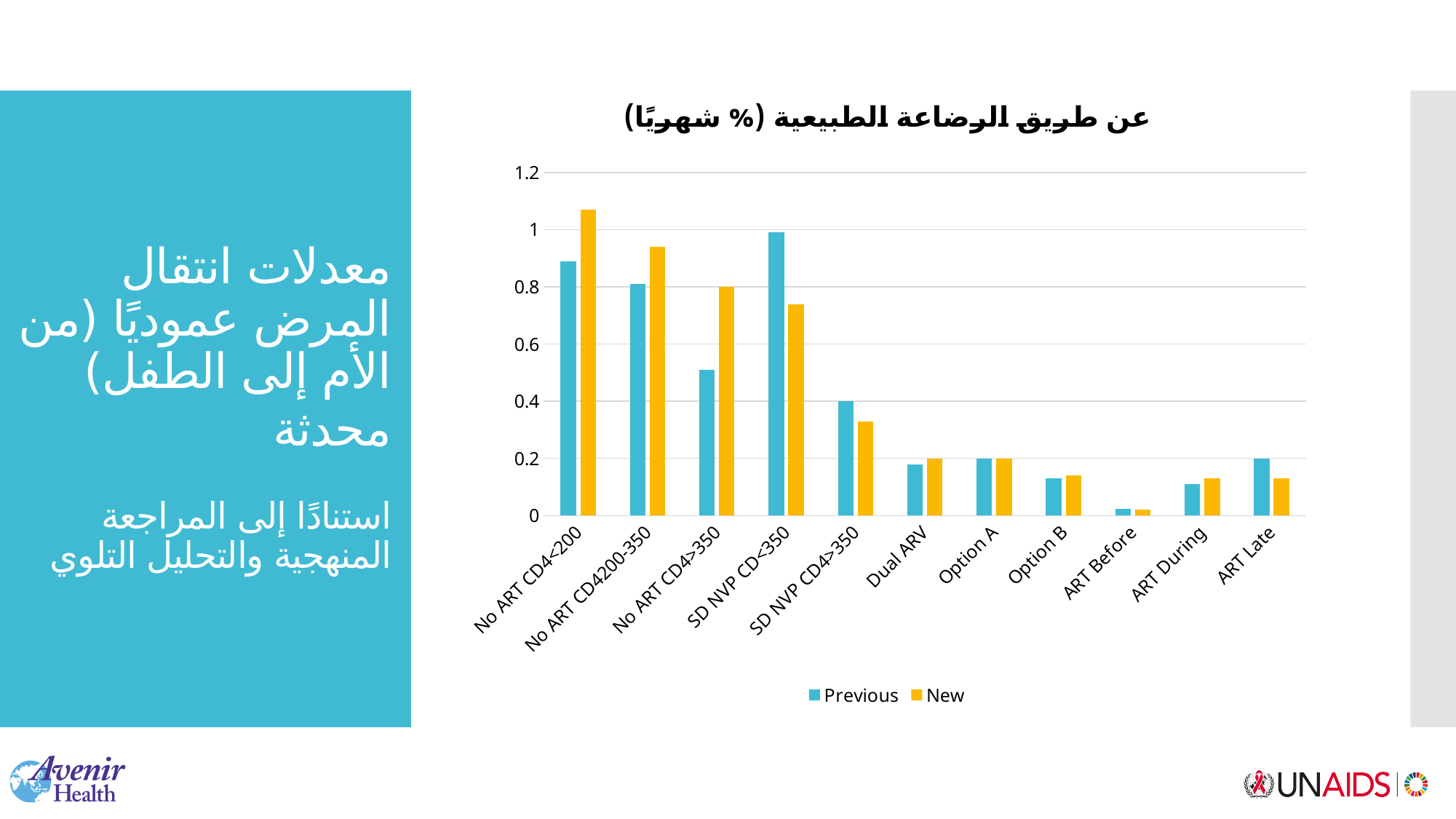
For No ART CD4<200, which is larger, the Previous value or the New value? New Is the New value for No ART CD4<200 greater or less than 1? greater What kind of chart is shown on the slide? bar chart Is the New value for SD NVP CD4>350 greater or less than 0.4? less For SD NVP CD<350, which is larger, the Previous value or the New value? Previous Which category has the tallest bar in the chart? No ART CD4<200 How many series does the chart's legend list? 2 Which series is shown in orange in the chart? New Which category has the lowest values for both Previous and New? ART Before What are the two series named in the chart's legend? Previous and New How many categories are shown on the x axis of the chart? 11 Is the Previous value for No ART CD4>350 greater or less than 0.4? greater